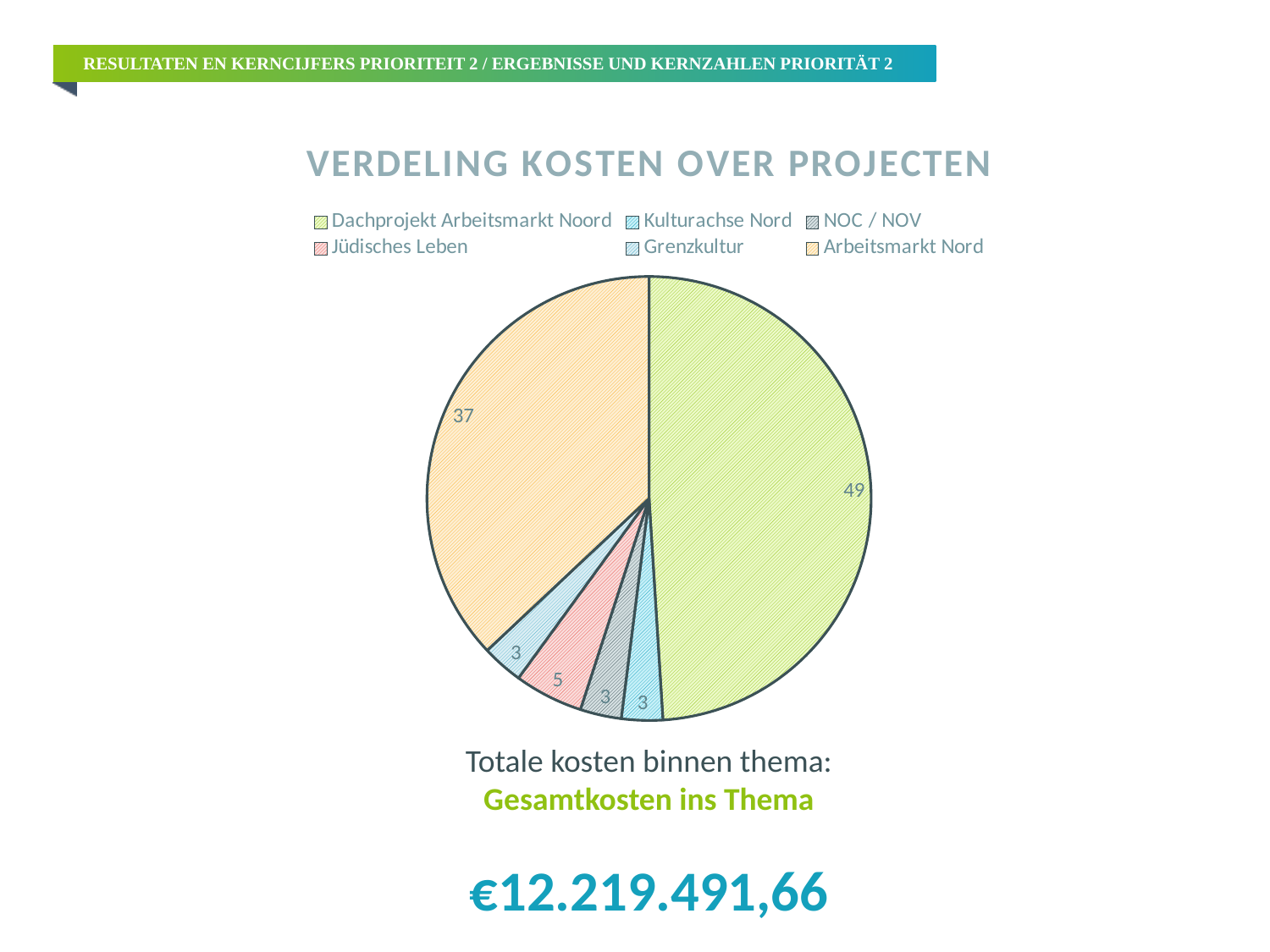
What is the difference between the values for Arbeitsmarkt Nord and Jüdisches Leben? 32 What value is shown for the Dachprojekt Arbeitsmarkt Noord slice? 49 How many slices does the pie chart have? 6 What is the title of the chart? VERDELING KOSTEN OVER PROJECTEN Which is larger, the slice for Arbeitsmarkt Nord or the slice for Jüdisches Leben? Arbeitsmarkt Nord What is the difference between the values for Dachprojekt Arbeitsmarkt Noord and Arbeitsmarkt Nord? 12 What value is shown for the Kulturachse Nord slice? 3 Which project has the largest slice of the pie? Dachprojekt Arbeitsmarkt Noord What kind of chart is shown on the slide? Pie chart How many entries does the legend list? 6 What value is shown for the Arbeitsmarkt Nord slice? 37 What value is shown for the Jüdisches Leben slice? 5